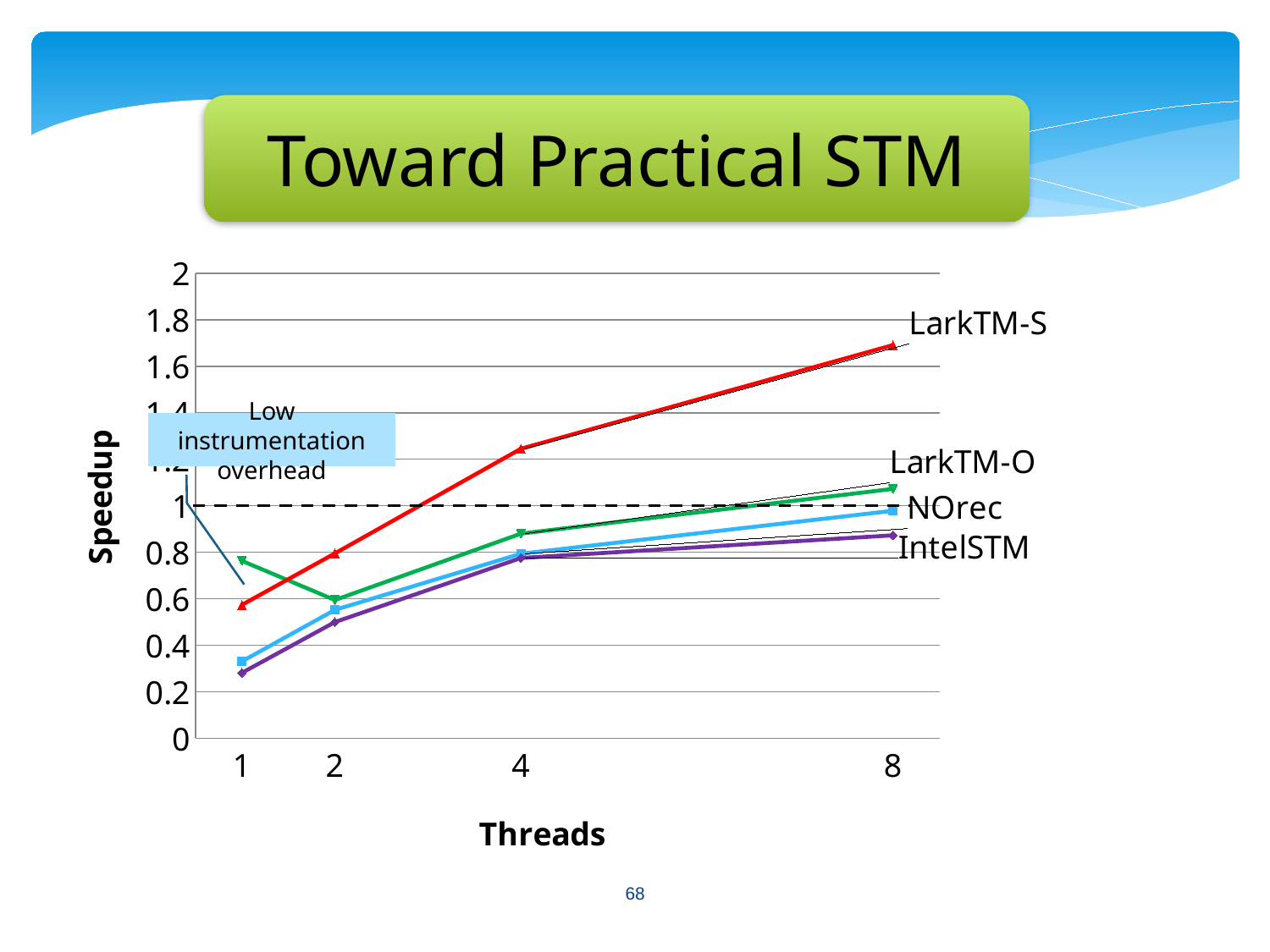
Is the speedup for LarkTM-S at 8 threads greater or less than 1.6? greater Is the speedup for IntelSTM at 1 thread greater or less than 0.4? less How many series (lines) are labelled on the chart? 4 Is the speedup for IntelSTM at 8 threads greater or less than 1? less Does the speedup for LarkTM-S rise or fall as the number of threads increases? rise What is the label of the y axis? Speedup Which series has the highest speedup at 8 threads? LarkTM-S Which series has the lowest speedup at 8 threads? IntelSTM At 4 threads, which has the larger speedup, LarkTM-S or LarkTM-O? LarkTM-S What kind of chart is shown on the slide? line chart How many thread counts are plotted along the x axis? 4